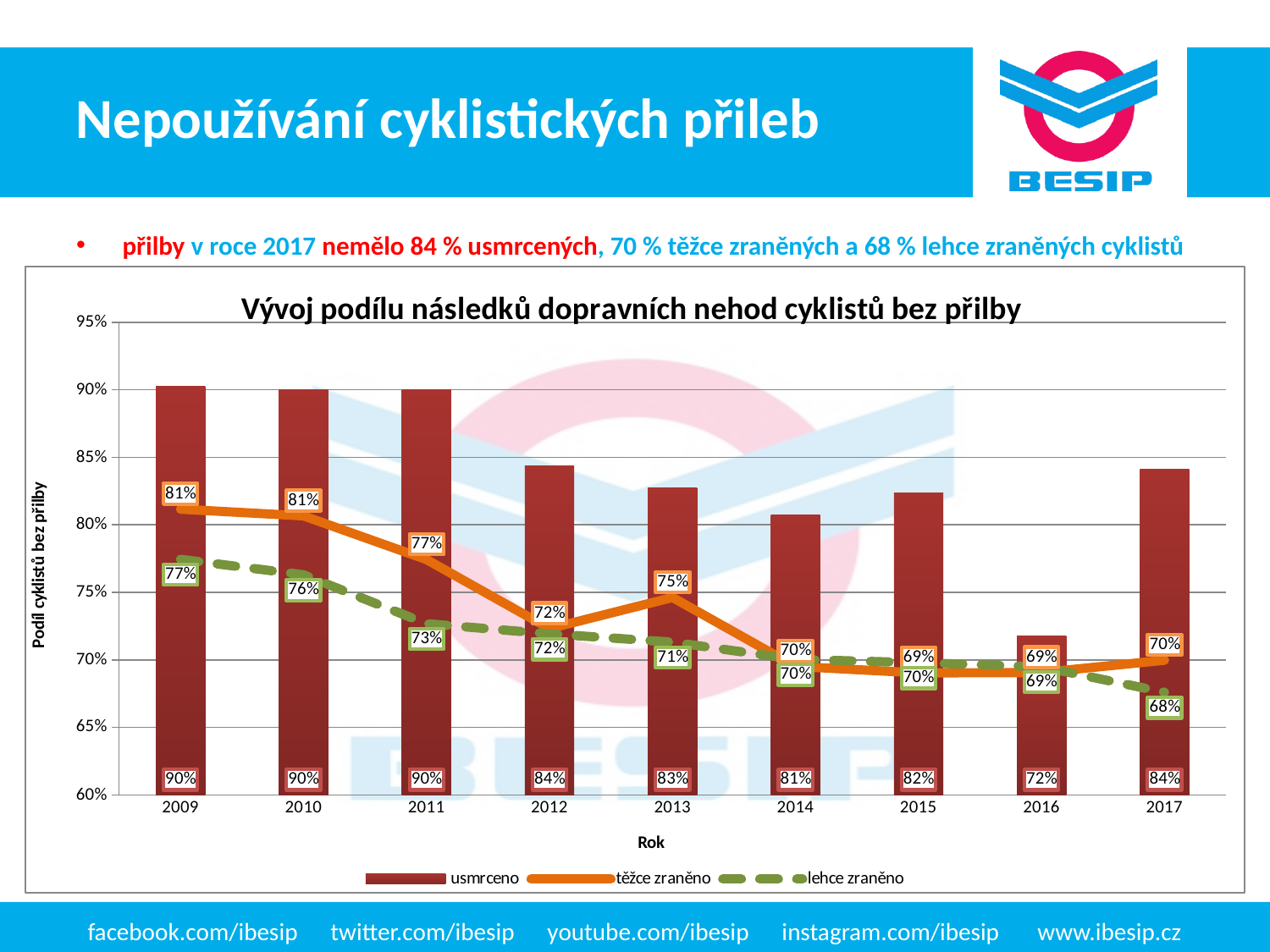
Which is larger in 2013: the těžce zraněno value or the lehce zraněno value? těžce zraněno Does the lehce zraněno series rise or fall from 2009 to 2017? fall What is the value for usmrceno in 2016? 72% What is the value for lehce zraněno in 2017? 68% What is the value for těžce zraněno in 2011? 77% In which year is the usmrceno value lowest? 2016 How many years are shown on the x axis? 9 In which year is the těžce zraněno value lowest? 2015 and 2016 What kind of chart is this? Combined bar and line chart How many series does the legend list? 3 What is the title of the chart? Vývoj podílu následků dopravních nehod cyklistů bez přilby What is the difference between the usmrceno values in 2009 and 2016? 18 percentage points